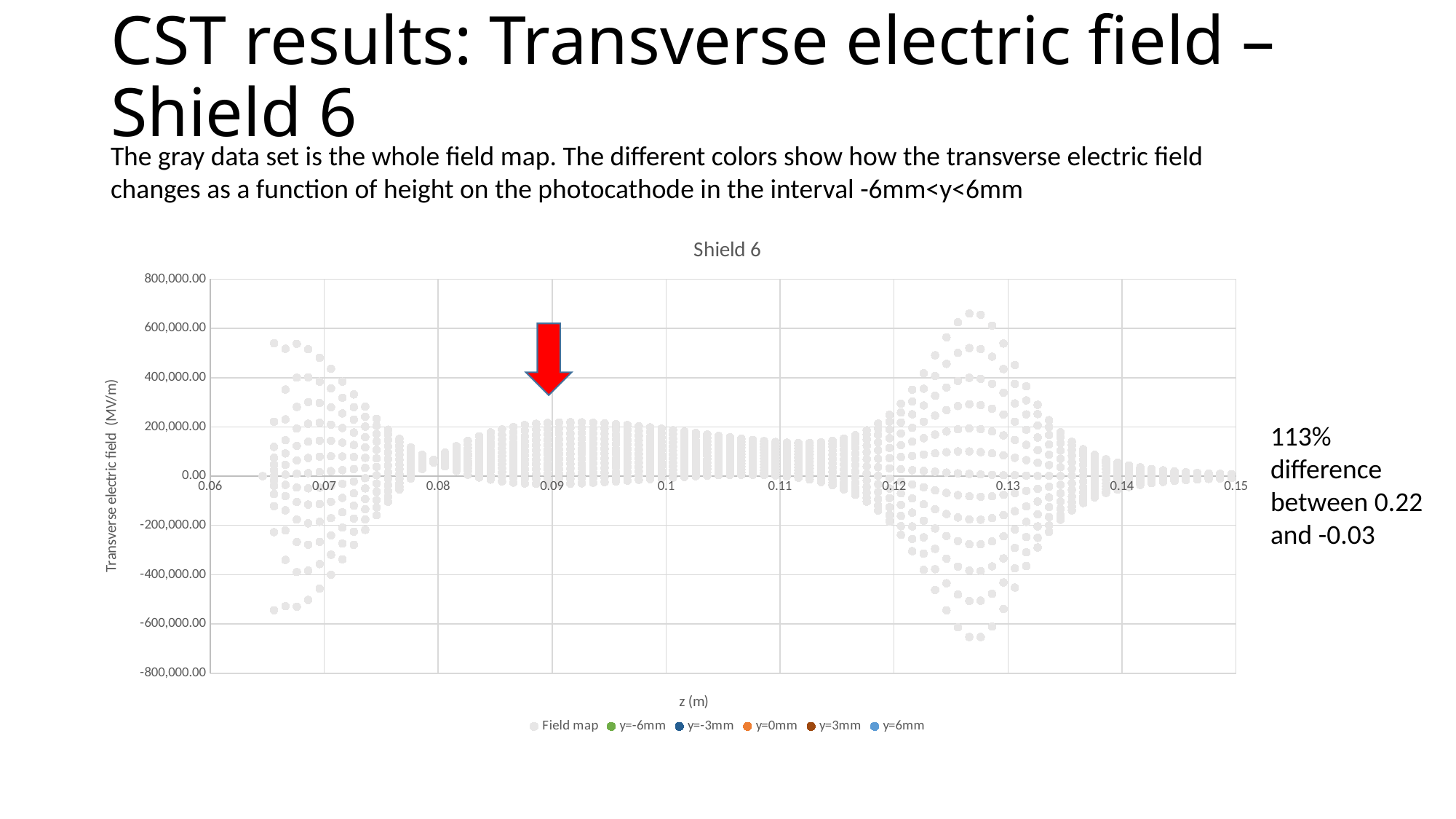
What is the title of the chart? Shield 6 Is the highest Field map value near z = 0.09 greater or less than 400,000.00? less Is the lowest Field map value near z = 0.13 greater or less than -600,000.00? less What is the label of the x axis of the chart? z (m) Is the highest Field map value near z = 0.07 greater or less than 400,000.00? greater How many series does the chart legend list? 6 What kind of chart is shown on the slide? scatter chart What is the maximum value shown on the vertical axis of the chart? 800,000.00 Which region has the larger peak Field map value: around z = 0.07 or around z = 0.13? around z = 0.13